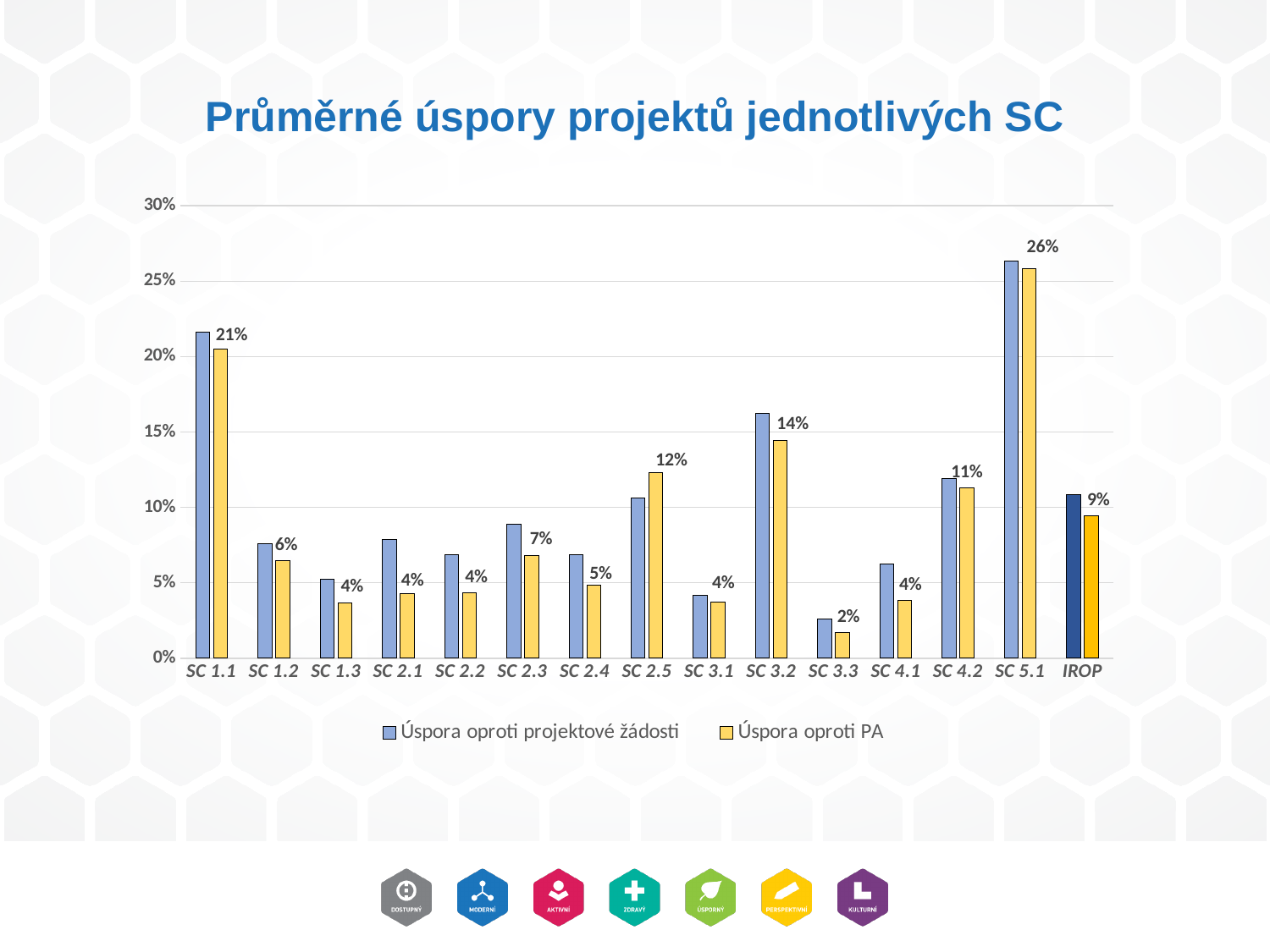
What is the labelled value of 'Úspora oproti PA' for IROP? 9% Which has a larger labelled 'Úspora oproti PA' value, SC 3.2 or SC 4.2? SC 3.2 How many series does the legend list? 2 Is the 'Úspora oproti projektové žádosti' value for SC 3.2 greater or less than 15%? greater What is the title of the chart? Průměrné úspory projektů jednotlivých SC What is the labelled value of 'Úspora oproti PA' for SC 2.5? 12% Which category has the highest labelled 'Úspora oproti PA' value? SC 5.1 What is the labelled value of 'Úspora oproti PA' for SC 5.1? 26% How many categories are shown on the x axis? 15 What type of chart is shown on the slide? bar chart What is the difference between the labelled 'Úspora oproti PA' values for SC 5.1 and SC 1.1? 5% Which category has the lowest labelled 'Úspora oproti PA' value? SC 3.3